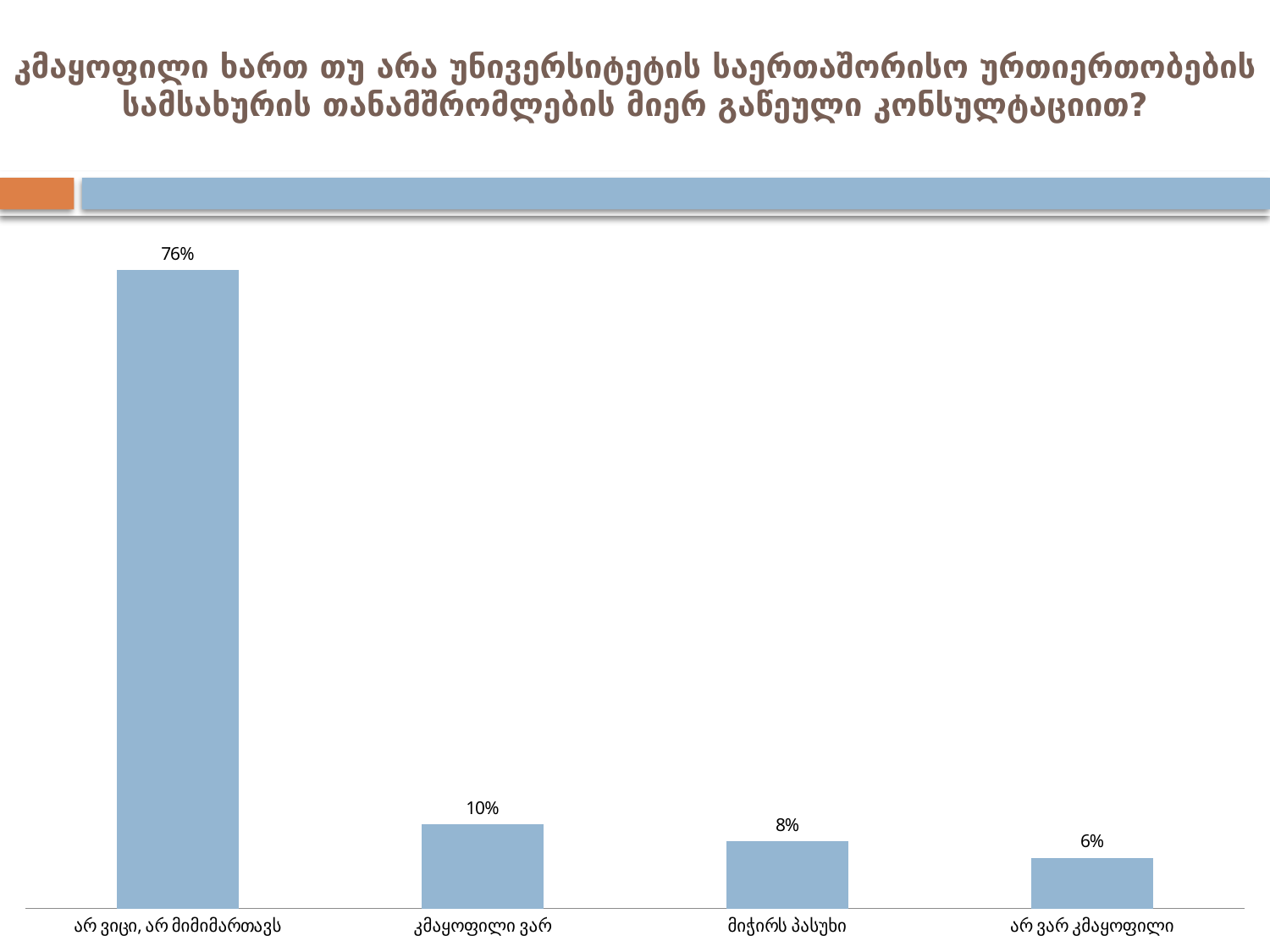
What is the value for "მიჭირს პასუხი"? 8% Which category has the lowest value? არ ვარ კმაყოფილი What kind of chart is shown on the slide? Bar chart What is the difference between the values for "მიჭირს პასუხი" and "არ ვარ კმაყოფილი"? 2% How many categories are shown in the chart? 4 What is the difference between the values for "არ ვიცი, არ მიმიმართავს" and "კმაყოფილი ვარ"? 66% Which is larger, the value for "კმაყოფილი ვარ" or the value for "არ ვარ კმაყოფილი"? კმაყოფილი ვარ Which category has the highest value? არ ვიცი, არ მიმიმართავს Do the values rise or fall from left to right across the categories? Fall What is the value for "არ ვიცი, არ მიმიმართავს"? 76% What is the value for "არ ვარ კმაყოფილი"? 6% What is the value for "კმაყოფილი ვარ"? 10%